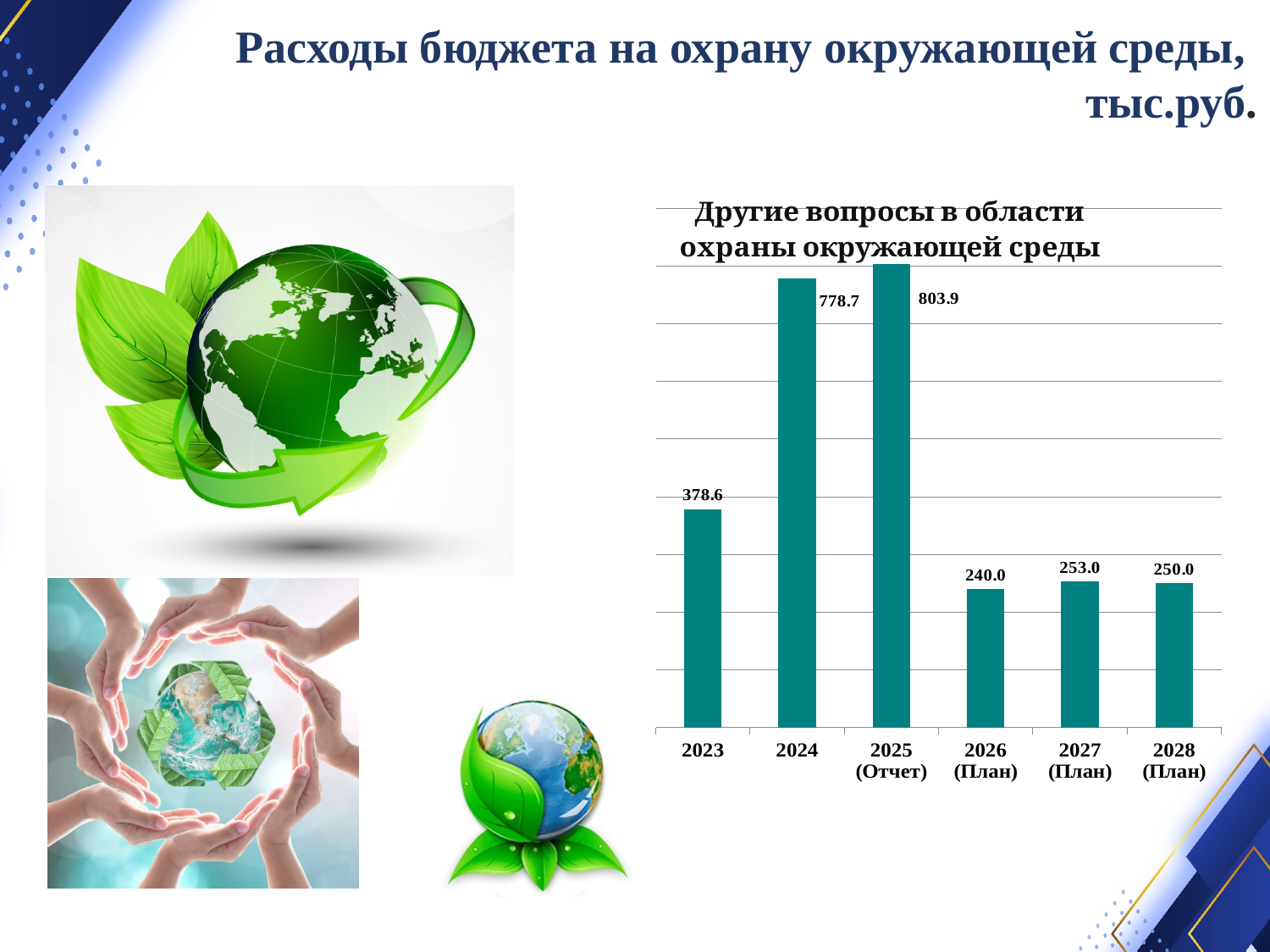
Which year has the lowest value? 2026 (План) Which is larger, the value for 2023 or the value for 2028 (План)? 2023 What is the value for 2023? 378.6 Which year has the highest value? 2025 (Отчет) What kind of chart is shown on the slide? Bar chart What is the title of the chart? Другие вопросы в области охраны окружающей среды What is the value for 2025 (Отчет)? 803.9 What is the value for 2026 (План)? 240.0 How many years are shown on the chart? 6 What is the value for 2027 (План)? 253.0 What is the difference between the values for 2025 (Отчет) and 2024? 25.2 What is the difference between the values for 2024 and 2023? 400.1